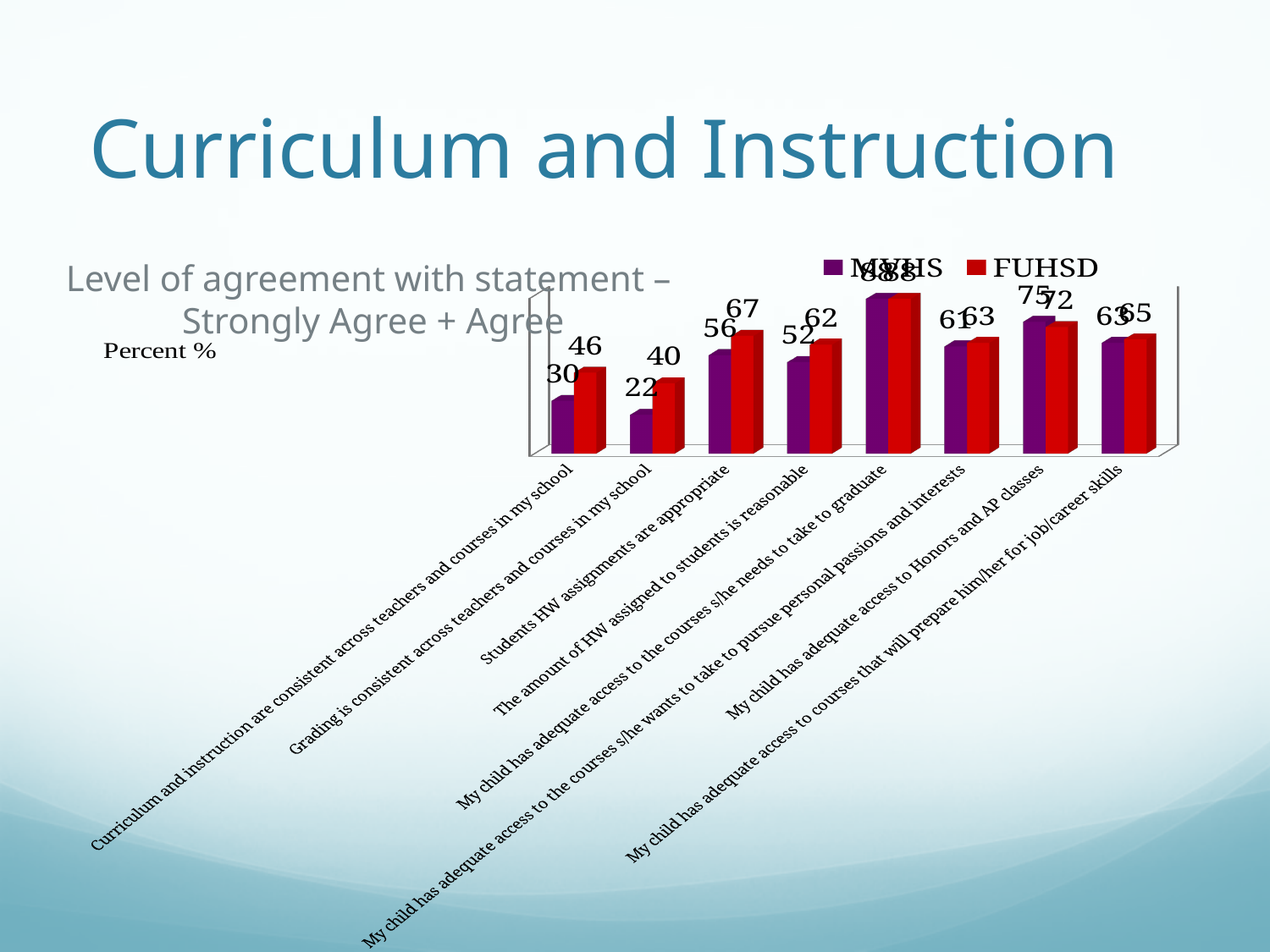
How many series does the legend list? 2 How many statements (categories) are plotted on the chart? 8 Which statement has the highest FUHSD value? My child has adequate access to the courses s/he needs to take to graduate What is the MVHS value for 'The amount of HW assigned to students is reasonable'? 52 Which statement has the lowest MVHS value? Grading is consistent across teachers and courses in my school What type of chart is shown on the slide? bar chart What is the FUHSD value for 'Grading is consistent across teachers and courses in my school'? 40 What is the FUHSD value for 'Students HW assignments are appropriate'? 67 What are the two series named in the legend? MVHS and FUHSD For 'Students HW assignments are appropriate', which is larger, the MVHS value or the FUHSD value? FUHSD What is the MVHS value for 'Curriculum and instruction are consistent across teachers and courses in my school'? 30 What is the difference between the FUHSD and MVHS values for 'Grading is consistent across teachers and courses in my school'? 18